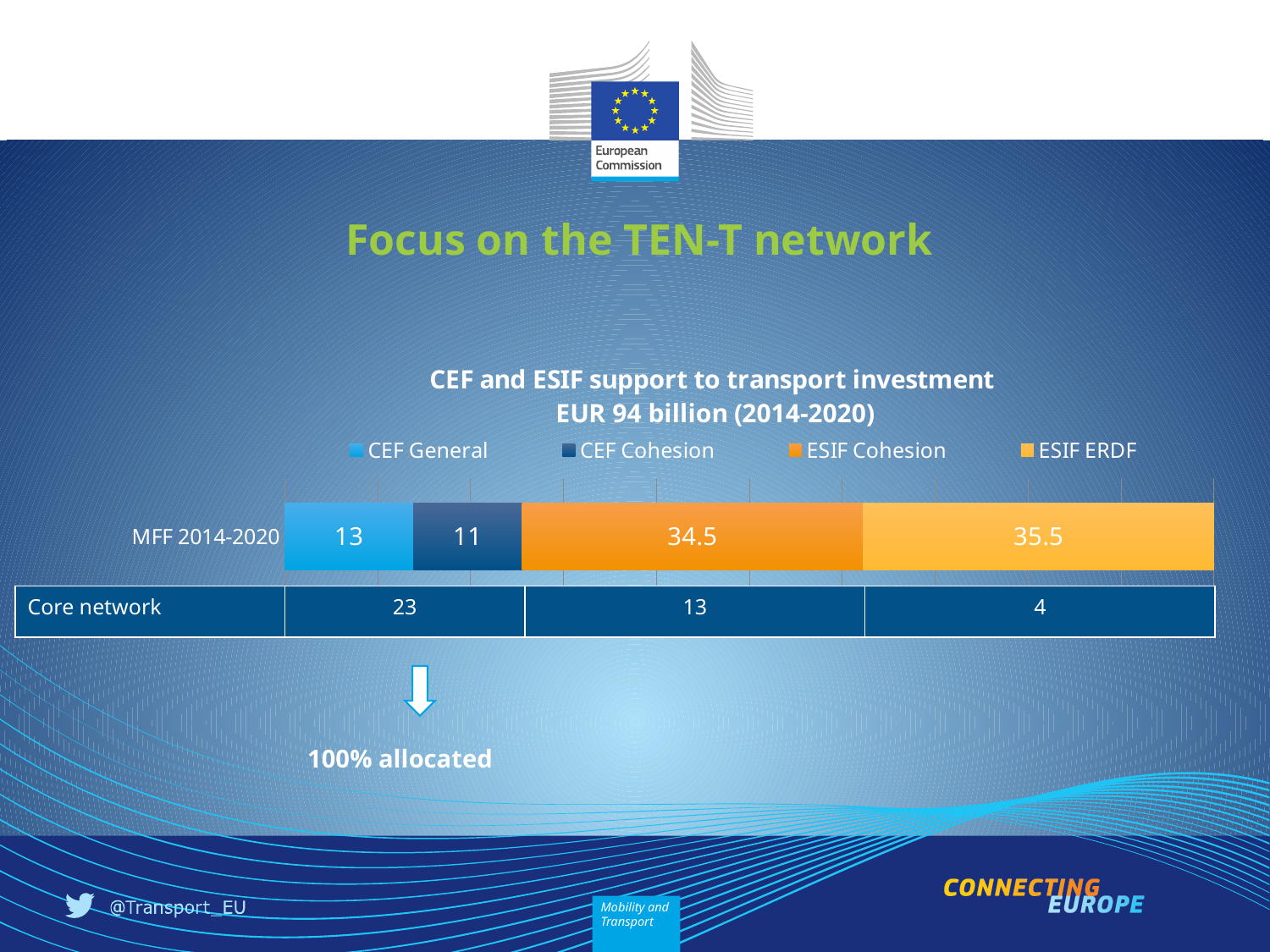
Which series has the smallest value in the MFF 2014-2020 bar? CEF Cohesion What is the difference between the ESIF ERDF and ESIF Cohesion values? 1 What is the difference between the CEF General and CEF Cohesion values? 2 What is the value for CEF General in the MFF 2014-2020 bar? 13 What kind of chart is shown on the slide? Stacked bar chart What is the total of the MFF 2014-2020 stacked bar? 94 What is the value for CEF Cohesion in the MFF 2014-2020 bar? 11 What is the value for ESIF Cohesion in the MFF 2014-2020 bar? 34.5 What is the value for ESIF ERDF in the MFF 2014-2020 bar? 35.5 Which is larger, CEF General or CEF Cohesion? CEF General How many series does the chart legend list? 4 Which series has the largest value in the MFF 2014-2020 bar? ESIF ERDF